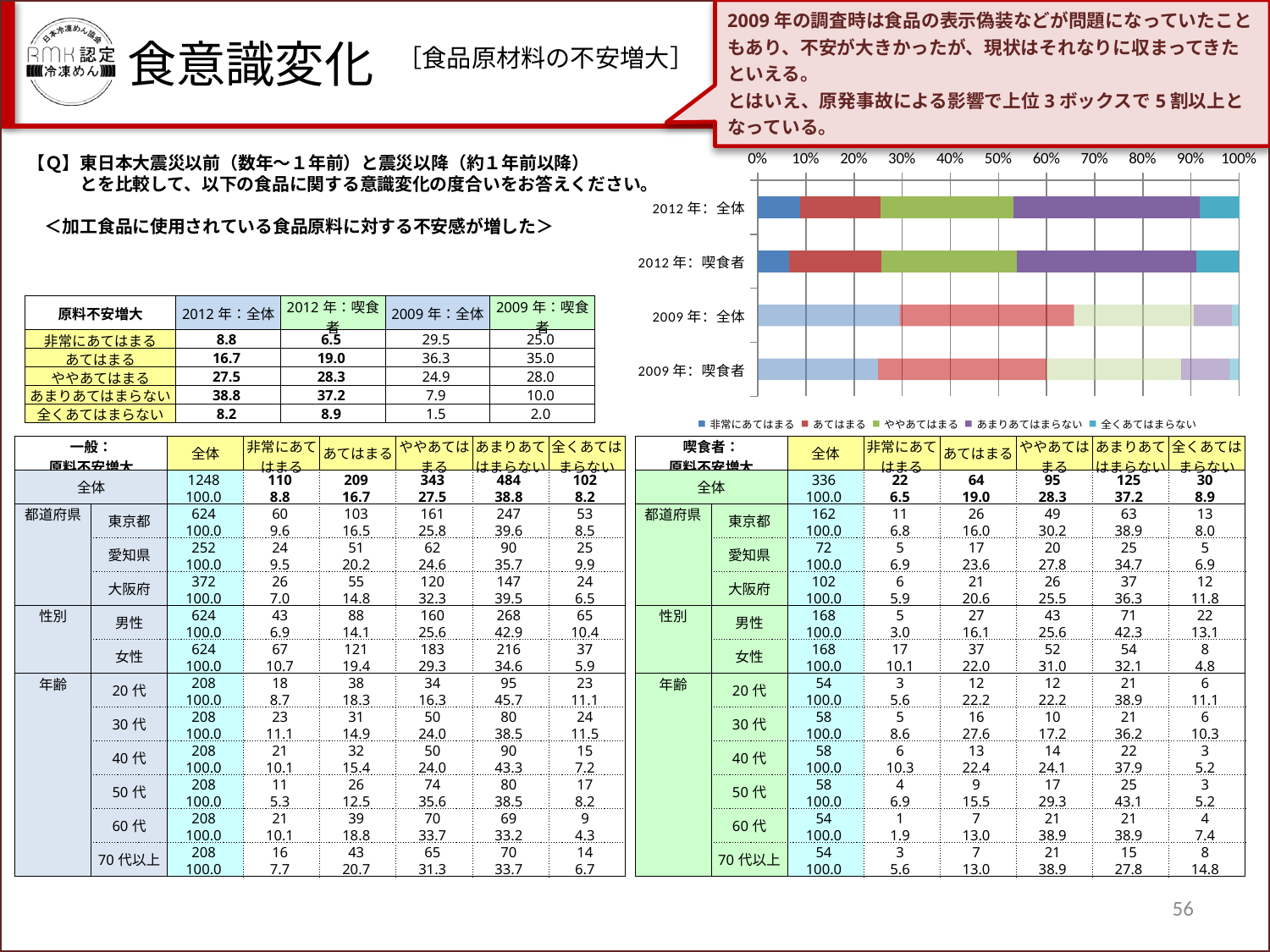
How many series does the chart's legend list? 5 Is the あまりあてはまらない segment for 2009年: 全体 greater or less than 10%? less Is the 非常にあてはまる segment for 2009年: 全体 greater or less than 20%? greater Which bar has the larger 非常にあてはまる segment, 2012年: 全体 or 2009年: 全体? 2009年: 全体 What is the first entry in the chart's legend? 非常にあてはまる Which bar has the largest 非常にあてはまる segment? 2009年: 全体 Is the あまりあてはまらない segment for 2012年: 全体 greater or less than 30%? greater What kind of chart is shown on the slide? Stacked bar chart Which bar has the larger あまりあてはまらない segment, 2012年: 全体 or 2009年: 全体? 2012年: 全体 How many bars (categories) does the chart show? 4 What is the highest value shown on the chart's horizontal axis? 100%